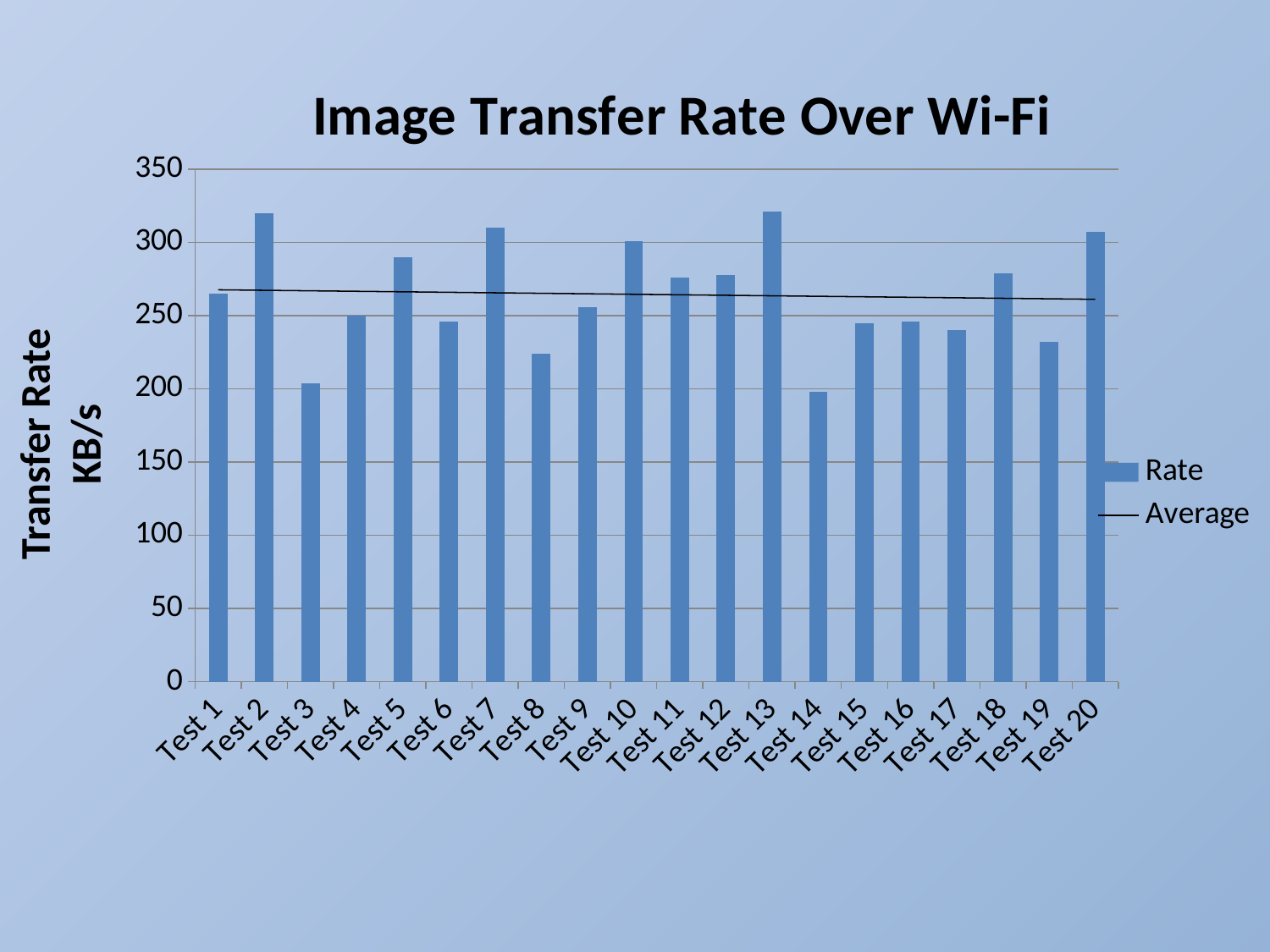
Is the value for Test 5 greater or less than 300? less What is the label on the vertical axis? Transfer Rate KB/s Is the value for Test 2 greater or less than 300? greater What type of chart is shown on the slide? Bar chart Is the value for Test 8 greater or less than 250? less Which has the higher transfer rate, Test 2 or Test 3? Test 2 Which has the higher transfer rate, Test 13 or Test 14? Test 13 How many tests are plotted along the x axis? 20 How many series does the legend list? 2 What is the title of the chart? Image Transfer Rate Over Wi-Fi